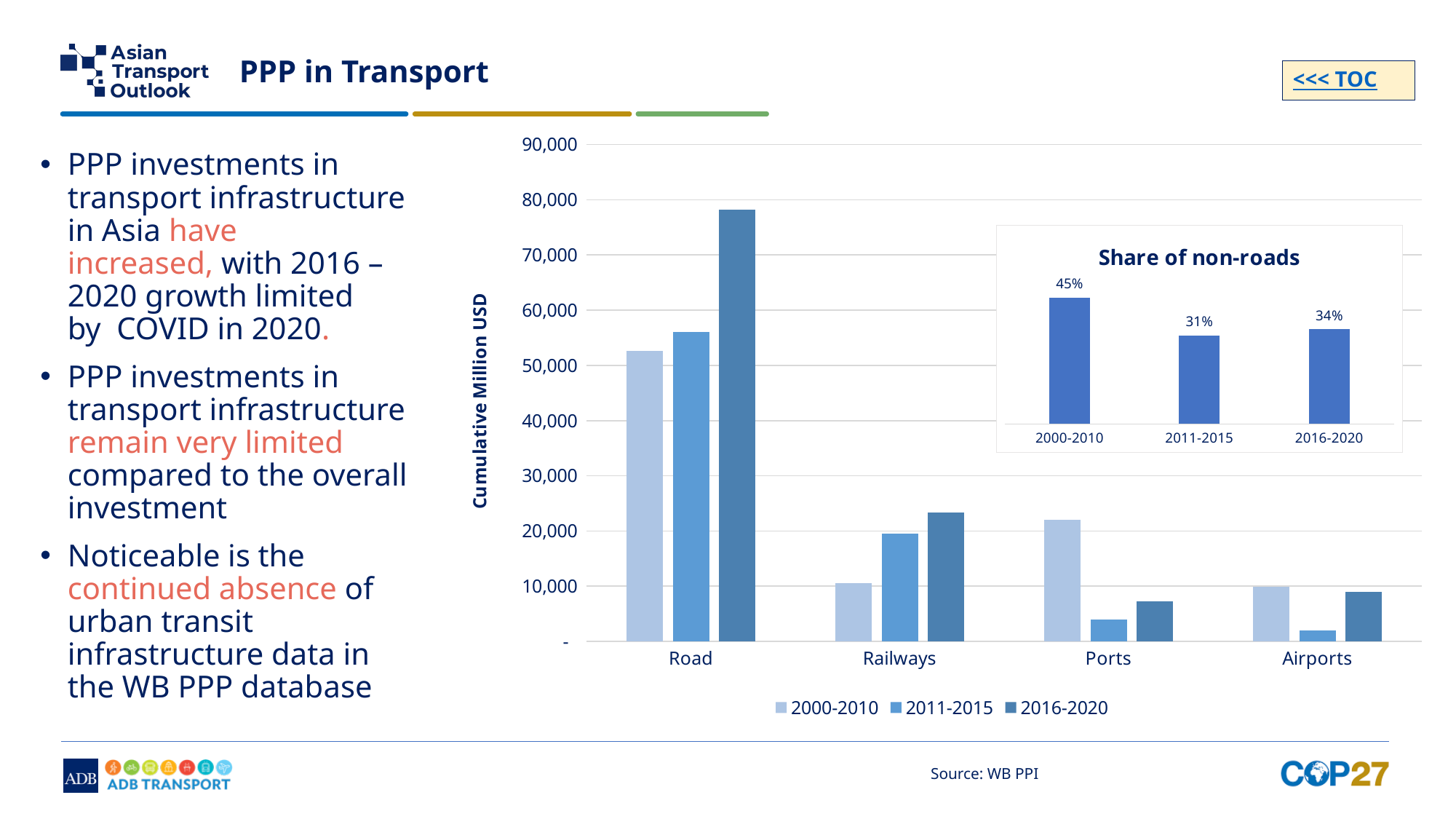
In the main bar chart, for Ports, which is larger: the 2000-2010 value or the 2011-2015 value? 2000-2010 In the 'Share of non-roads' chart, what is the value for 2011-2015? 31% In the 'Share of non-roads' chart, which period has the lowest share? 2011-2015 What is the y-axis label of the main bar chart? Cumulative Million USD In the main bar chart on the right, how many series does the legend list? 3 In the main bar chart on the right, how many transport categories are shown on the x axis? 4 In the main bar chart, which category has the highest value for 2016-2020? Road What kind of chart is the main chart on the right of the slide? Bar chart In the 'Share of non-roads' chart, which period has the highest share? 2000-2010 In the main bar chart, is the value for Road in 2016-2020 greater or less than 70,000? greater In the 'Share of non-roads' chart, what is the difference between the 2000-2010 and 2016-2020 values? 11 percentage points In the 'Share of non-roads' chart, what is the value for 2000-2010? 45%